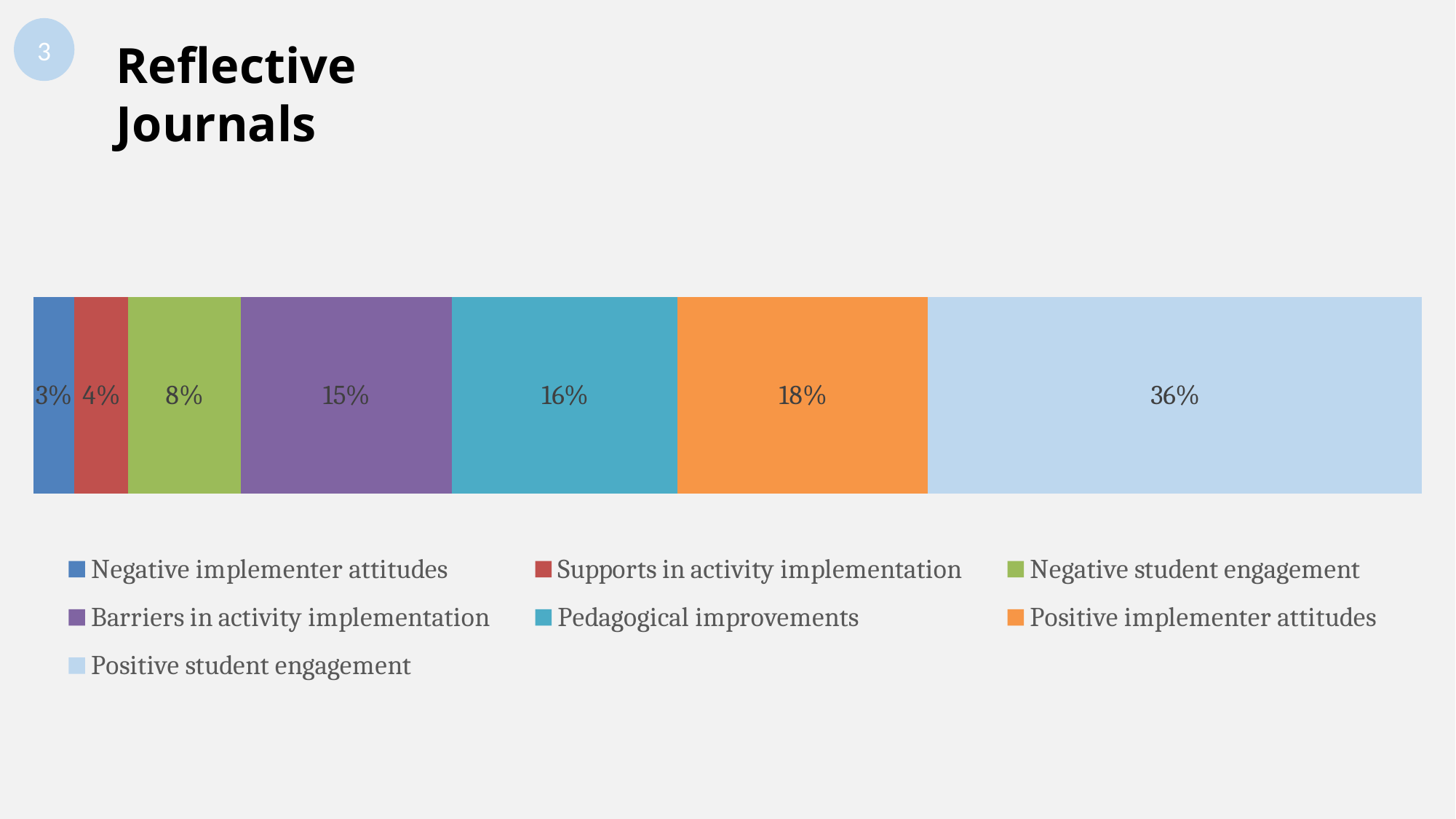
What percentage is shown for Negative student engagement? 8% Which category has the largest share of the bar? Positive student engagement What percentage is shown for Positive student engagement? 36% Which is larger, the percentage for Positive implementer attitudes or for Pedagogical improvements? Positive implementer attitudes What is the total of all the segments in the stacked bar? 100% Which category has the smallest share of the bar? Negative implementer attitudes What kind of chart is shown on the slide? Stacked bar chart What percentage is shown for Pedagogical improvements? 16% How many series does the legend list? 7 How many segments make up the stacked bar? 7 What is the difference between the percentages for Positive implementer attitudes and Negative implementer attitudes? 15% What percentage is shown for Barriers in activity implementation? 15%